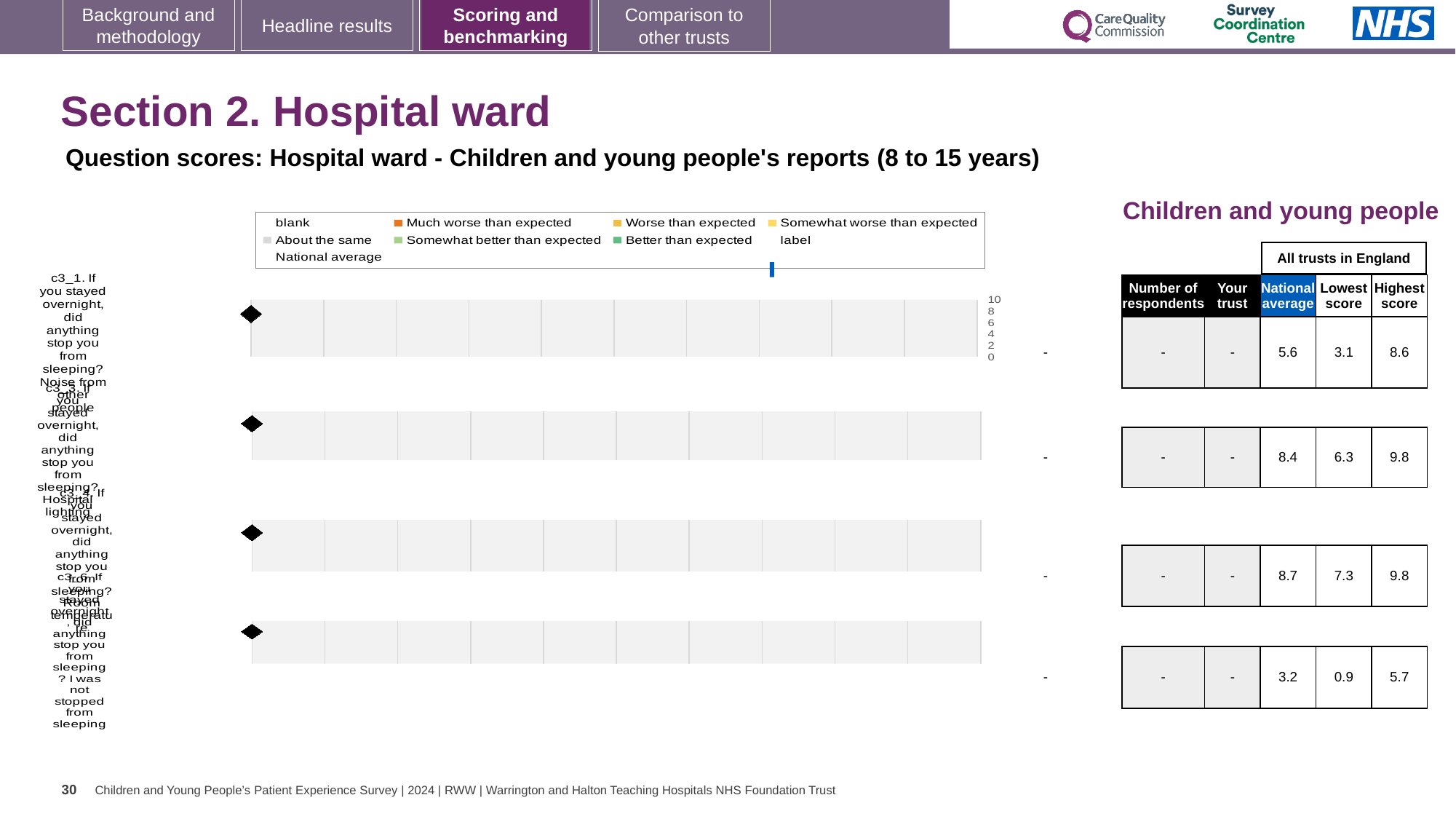
In the table beside the chart, what is the highest score for the first row (c3_1, noise from other people)? 8.6 How many question rows (bars) does the chart have? 4 What colour does the legend use for 'Much worse than expected'? orange In the table beside the chart, what value is shown for 'Your trust' in the first row? - In the table beside the chart, what is the national average for the first row (c3_1, noise from other people)? 5.6 In the table beside the chart, what is the lowest score for the second row (c3_3, hospital lighting)? 6.3 Which row in the table beside the chart has the lowest national average? the fourth row (c3_6, I was not stopped from sleeping), 3.2 What kind of chart is shown on the slide? bar chart Which row in the table beside the chart has the highest national average? the third row (c3_4, room temperature), 8.7 What is the maximum value shown on the chart's score axis? 10 How many entries does the chart legend list? 9 In the table beside the chart, what is the difference between the highest score and the lowest score for the fourth row (c3_6)? 4.8